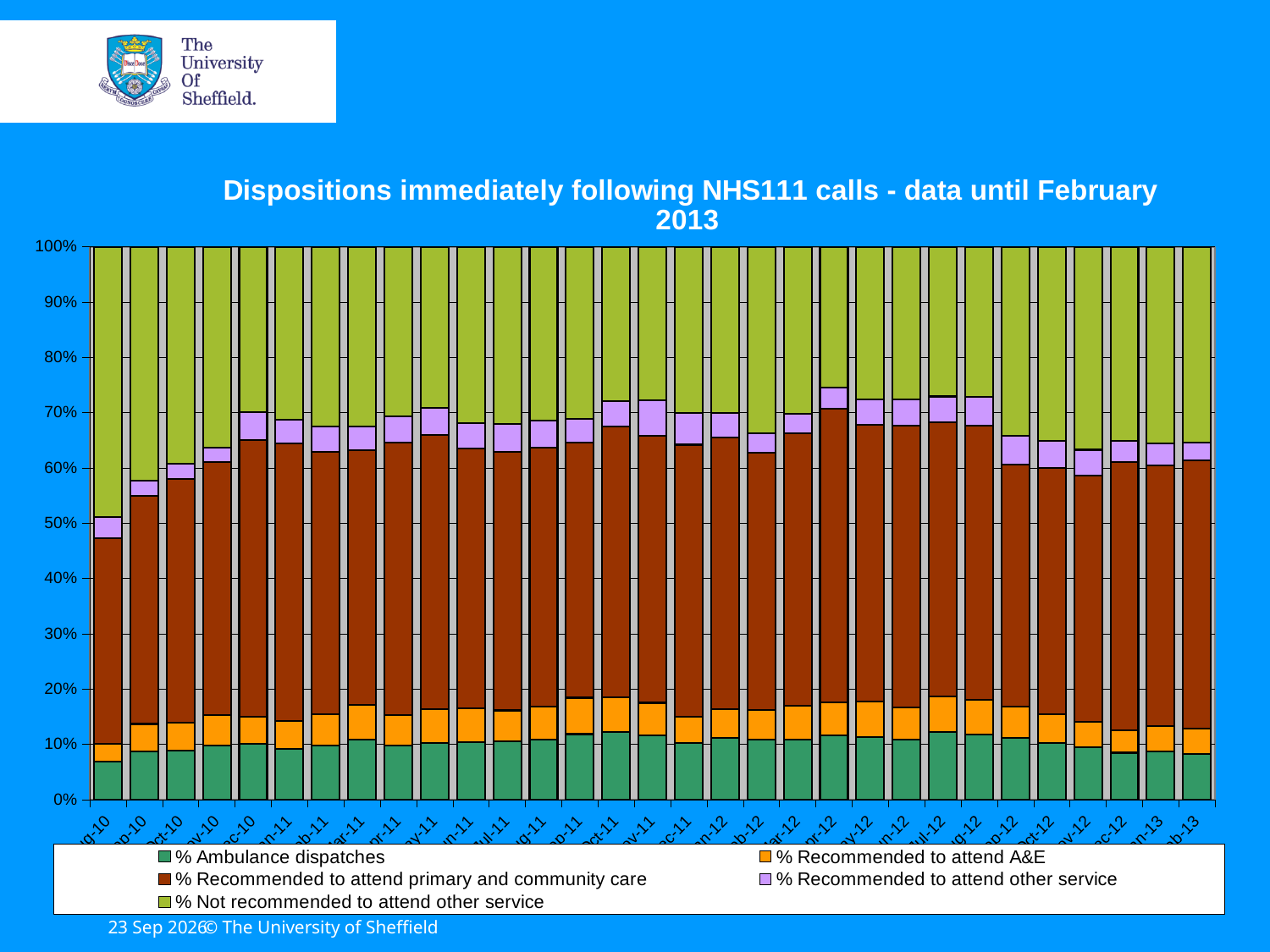
How many series does the legend list? 5 In the leftmost bar, is the % Ambulance dispatches segment greater or less than 10%? less In the leftmost bar, is the % Recommended to attend primary and community care segment greater or less than 30%? greater Which series forms the bottom segment of each stacked bar? % Ambulance dispatches What is the highest value shown on the y axis? 100% What is the title of the chart? Dispositions immediately following NHS111 calls - data until February 2013 What kind of chart is shown on the slide? Stacked bar chart In the leftmost bar, which is larger: the % Not recommended to attend other service segment or the % Ambulance dispatches segment? % Not recommended to attend other service What does each stacked bar total? 100%